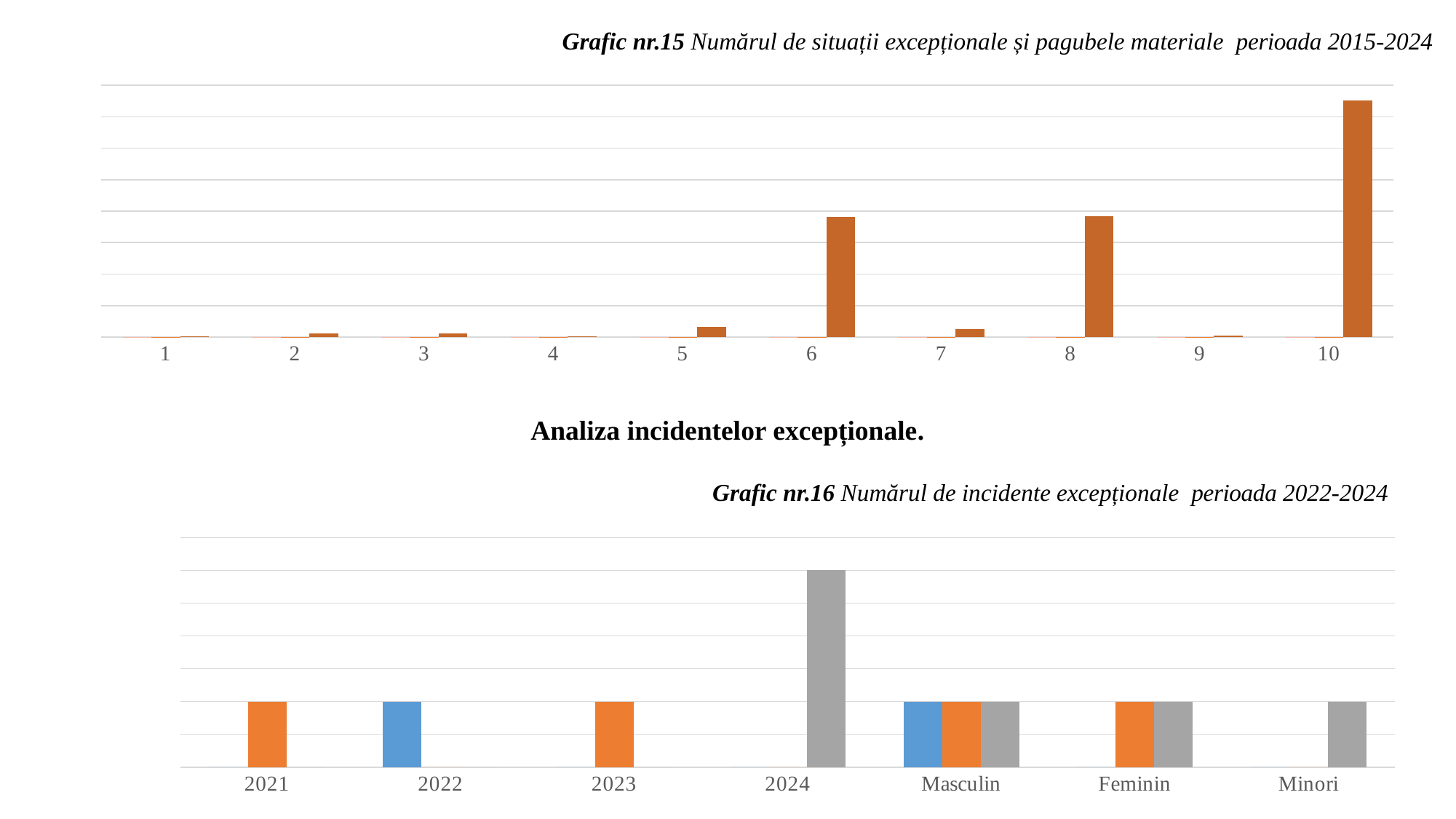
In the chart titled 'Grafic nr.16', what colour is the bar for 2022? blue In the chart titled 'Grafic nr.15', which category has the highest bar? 10 In the chart titled 'Grafic nr.15', how many categories are shown on the x axis? 10 In the chart titled 'Grafic nr.16', which is larger, the value for 2024 or the value for 2021? 2024 In the chart titled 'Grafic nr.16', which category has the tallest bar? 2024 In the chart titled 'Grafic nr.15', which is larger, the value for category 6 or the value for category 2? category 6 What kind of chart is 'Grafic nr.16'? bar chart In the chart titled 'Grafic nr.16', how many bars are shown for the category 'Masculin'? 3 In the chart titled 'Grafic nr.16', how many categories are shown on the x axis? 7 What is the full title of the top chart on the slide? Grafic nr.15 Numărul de situații excepționale și pagubele materiale perioada 2015-2024 What kind of chart is 'Grafic nr.15'? bar chart In the chart titled 'Grafic nr.15', is the bar for category 10 taller or shorter than the bar for category 6? taller